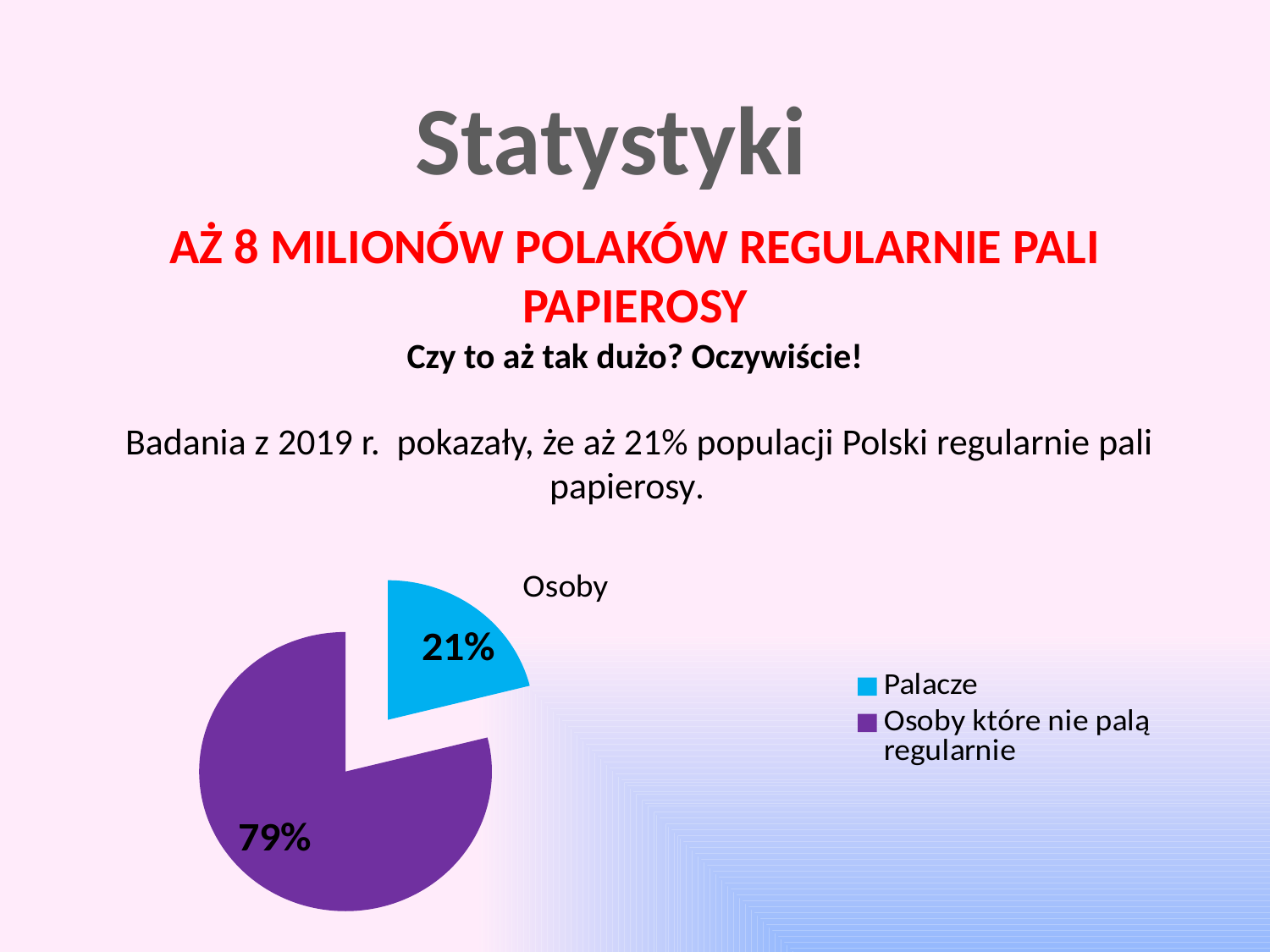
What is the difference in percentage points between the "Osoby które nie palą regularnie" slice and the "Palacze" slice? 58 What kind of chart is shown on the slide? pie chart Which slice of the pie is the largest? Osoby które nie palą regularnie What share of the pie does the "Palacze" slice represent? 21% Which is larger: the "Palacze" slice or the "Osoby które nie palą regularnie" slice? Osoby które nie palą regularnie Which slice of the pie is the smallest? Palacze What is the title of the pie chart? Osoby How many slices does the pie chart have? 2 How many entries does the legend list? 2 What colour is the "Palacze" slice? blue What share of the pie does the "Osoby które nie palą regularnie" slice represent? 79%